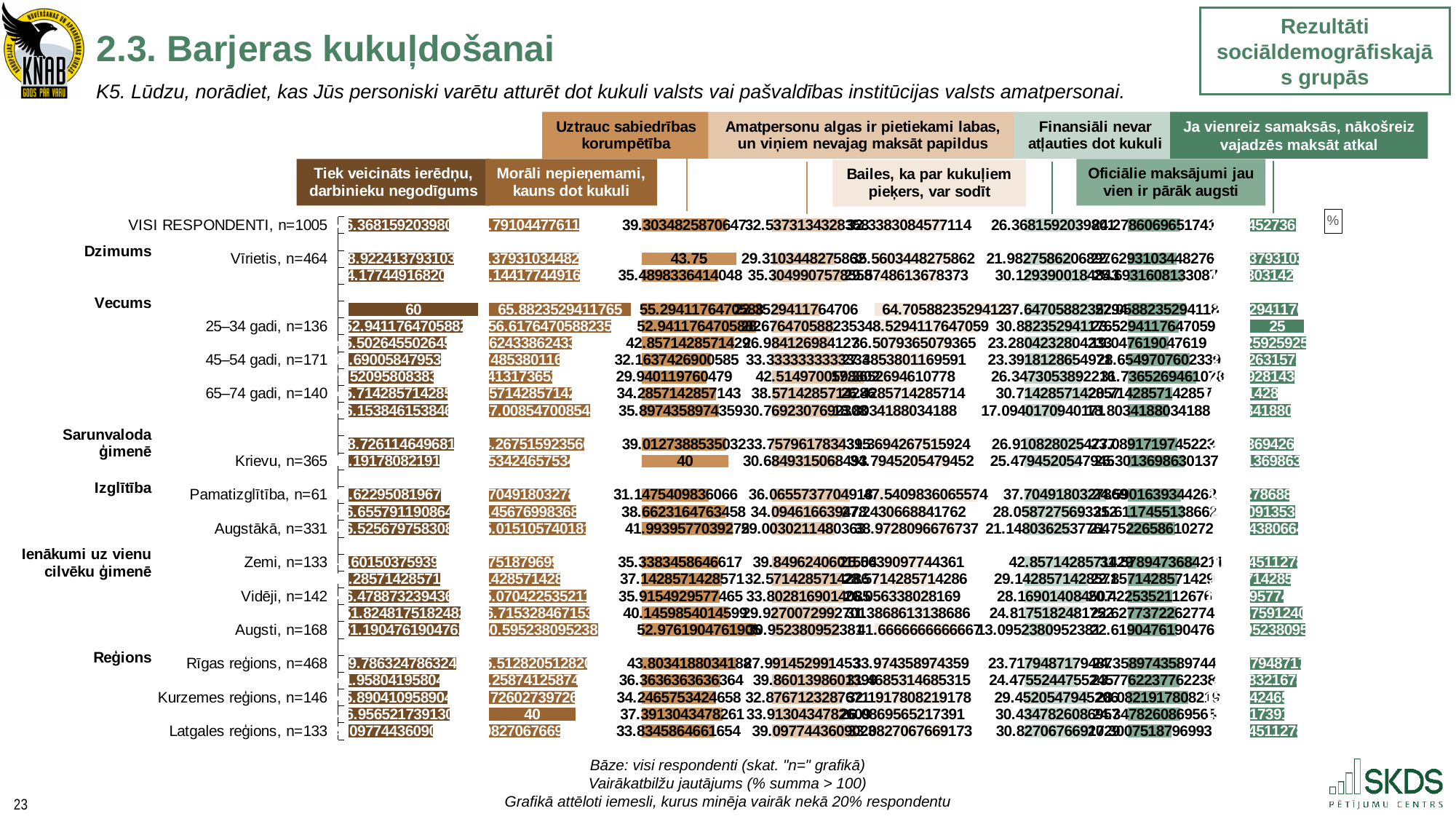
What is the title of the slide containing the chart? 2.3. Barjeras kukuļdošanai What is the value for Krievu, n=365 in the series "Uztrauc sabiedrības korumpētība"? 40 In the series "Uztrauc sabiedrības korumpētība", which is larger: the value for Vīrietis, n=464 or for Krievu, n=365? Vīrietis, n=464 Which legend entry is shown in dark green? Ja vienreiz samaksās, nākošreiz vajadzēs maksāt atkal How many series does the legend list? 8 What kind of chart is shown on the slide? bar chart What is the value for 25–34 gadi, n=136 in the series "Ja vienreiz samaksās, nākošreiz vajadzēs maksāt atkal"? 25 In the series "Uztrauc sabiedrības korumpētība", what is the difference between the value for Vīrietis, n=464 and the value for Krievu, n=365? 3.75 What is the value for Vīrietis, n=464 in the series "Uztrauc sabiedrības korumpētība"? 43.75